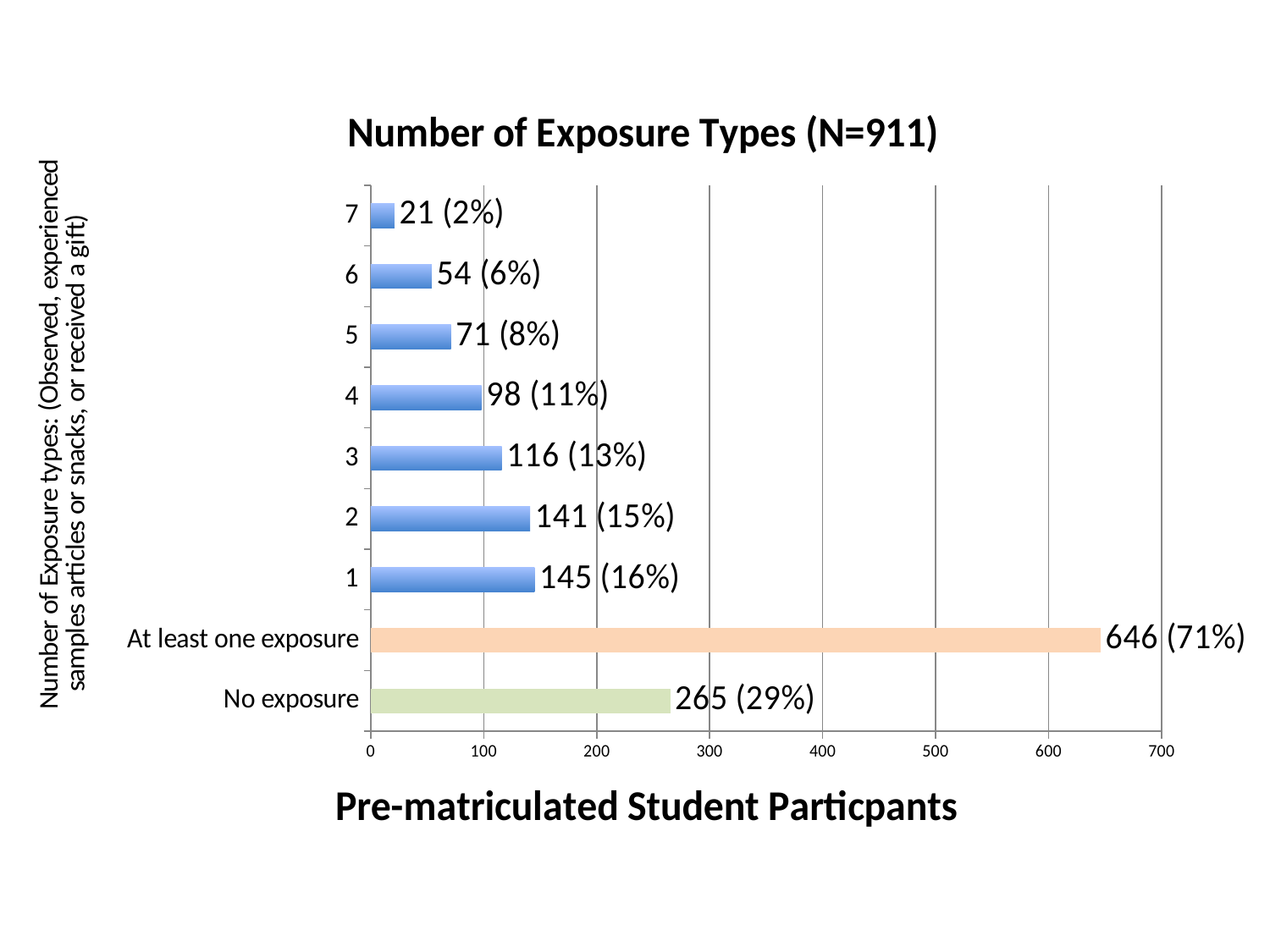
What kind of chart is shown on the slide? Bar chart Which category has the longest bar? At least one exposure How many participants reported 3 exposure types? 116 What is the data label shown for the 'No exposure' bar? 265 (29%) Which category has the shortest bar? 7 Is the value for 'No exposure' greater or less than 200? greater What is the title of the chart? Number of Exposure Types (N=911) Which has more participants: 4 exposure types or 5 exposure types? 4 What percentage is shown for 7 exposure types? 2% What is the data label shown for the 'At least one exposure' bar? 646 (71%) What is the difference in participants between 1 exposure type and 2 exposure types? 4 How many categories are shown on the vertical axis? 9